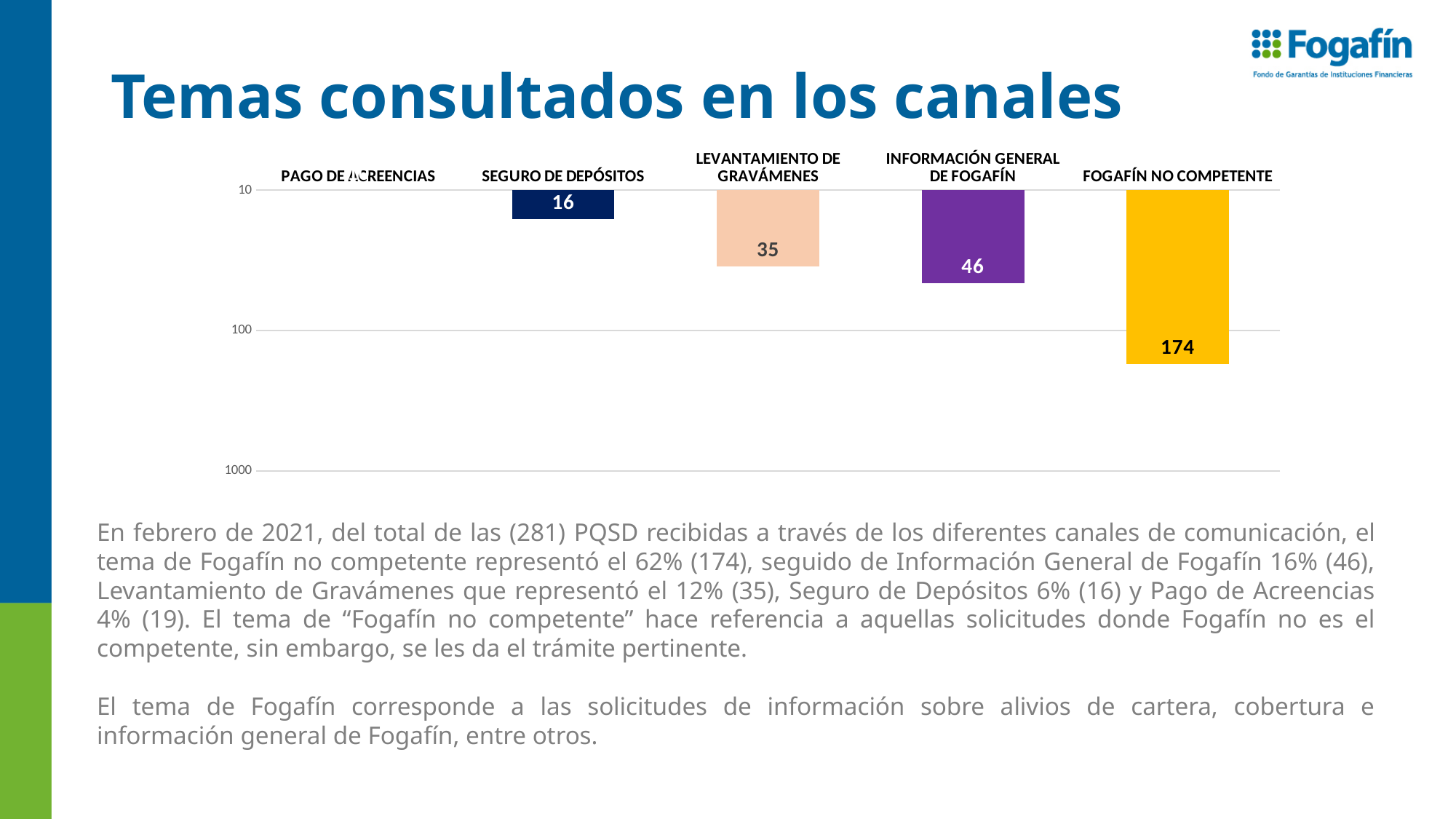
Which is larger, the value for LEVANTAMIENTO DE GRAVÁMENES or the value for SEGURO DE DEPÓSITOS? LEVANTAMIENTO DE GRAVÁMENES How many categories are labelled on the chart? 5 What is the value for FOGAFÍN NO COMPETENTE? 174 Is the value for FOGAFÍN NO COMPETENTE greater or less than 100? greater What is the value for INFORMACIÓN GENERAL DE FOGAFÍN? 46 Which category has the highest value? FOGAFÍN NO COMPETENTE What is the difference between the values for FOGAFÍN NO COMPETENTE and INFORMACIÓN GENERAL DE FOGAFÍN? 128 What is the difference between the values for INFORMACIÓN GENERAL DE FOGAFÍN and LEVANTAMIENTO DE GRAVÁMENES? 11 What kind of chart is shown on the slide? bar chart What is the value for SEGURO DE DEPÓSITOS? 16 What is the title of the slide containing the chart? Temas consultados en los canales What is the value for LEVANTAMIENTO DE GRAVÁMENES? 35